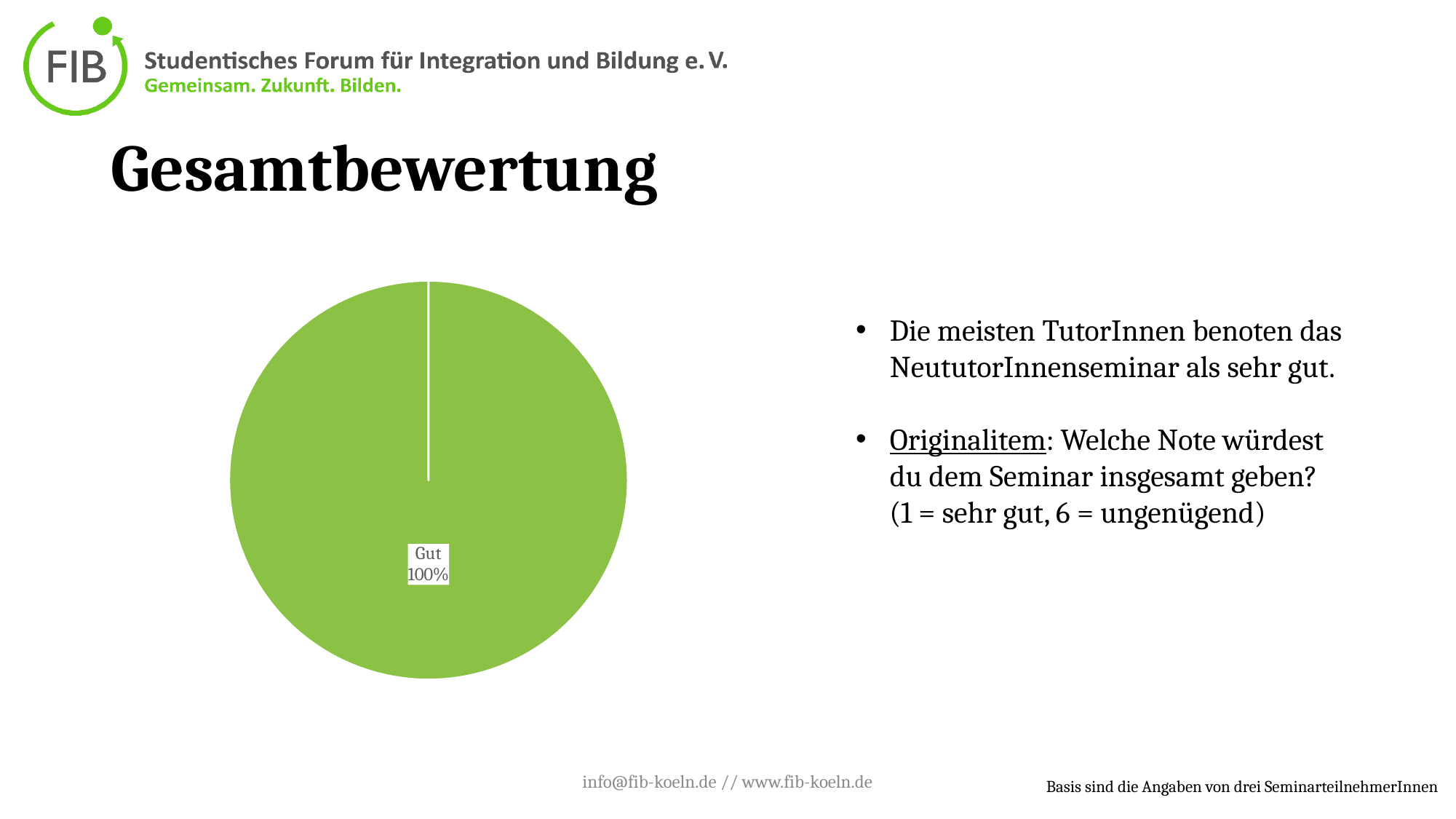
What kind of chart is shown on the slide? pie chart What is the label of the only slice in the pie chart? Gut What colour is the pie chart slice? green What share of the pie does the "Gut" slice take up? 100% How many slices does the pie chart contain? 1 Which category makes up the largest share of the pie chart? Gut What percentage is shown for the slice labelled "Gut"? 100%